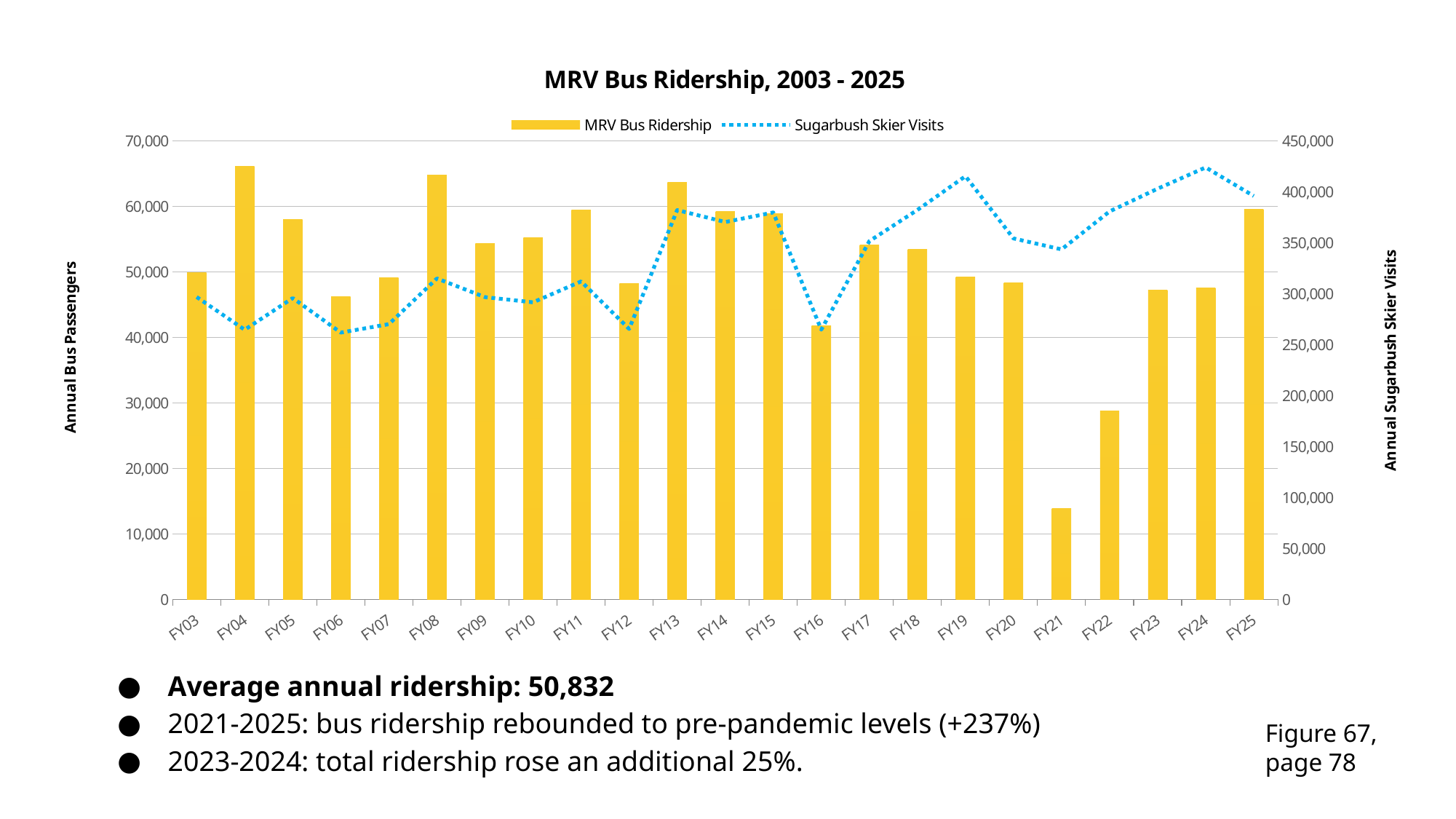
Is the MRV Bus Ridership for FY04 greater or less than 60,000? greater Is the Sugarbush Skier Visits value for FY24 greater or less than 400,000? greater Which fiscal year has the highest MRV Bus Ridership? FY04 What is the title of the chart? MRV Bus Ridership, 2003 - 2025 Which fiscal year has the lowest MRV Bus Ridership? FY21 Do MRV Bus Ridership values rise or fall from FY21 to FY25? rise How many fiscal years are shown on the x axis? 23 Which has the larger MRV Bus Ridership, FY24 or FY25? FY25 Is the MRV Bus Ridership for FY22 greater or less than 30,000? less How many series does the legend list? 2